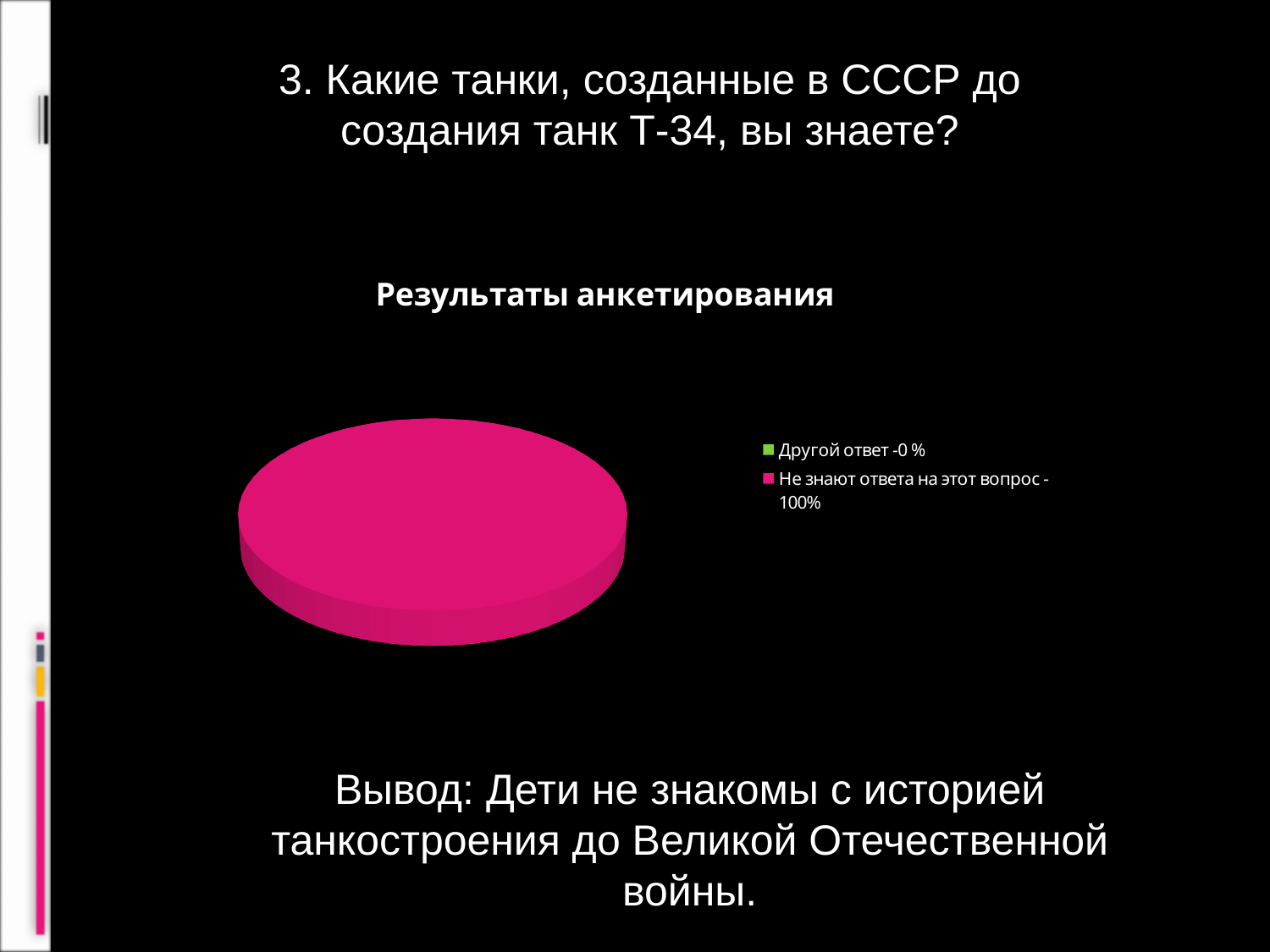
Which is larger: the share for "Другой ответ" or the share for "Не знают ответа на этот вопрос"? Не знают ответа на этот вопрос What share of respondents is shown for "Не знают ответа на этот вопрос"? 100% What is the title of the chart? Результаты анкетирования What is the difference between the share for "Не знают ответа на этот вопрос" and the share for "Другой ответ"? 100% Which category has the smallest share of the pie? Другой ответ What share of the whole pie does the "Не знают ответа на этот вопрос" slice occupy? 100% What colour is the slice for "Не знают ответа на этот вопрос" in the legend? pink What kind of chart is shown on the slide? pie chart Which category has the largest share of the pie? Не знают ответа на этот вопрос How many entries does the chart legend list? 2 What share of respondents is shown for "Другой ответ"? 0 %